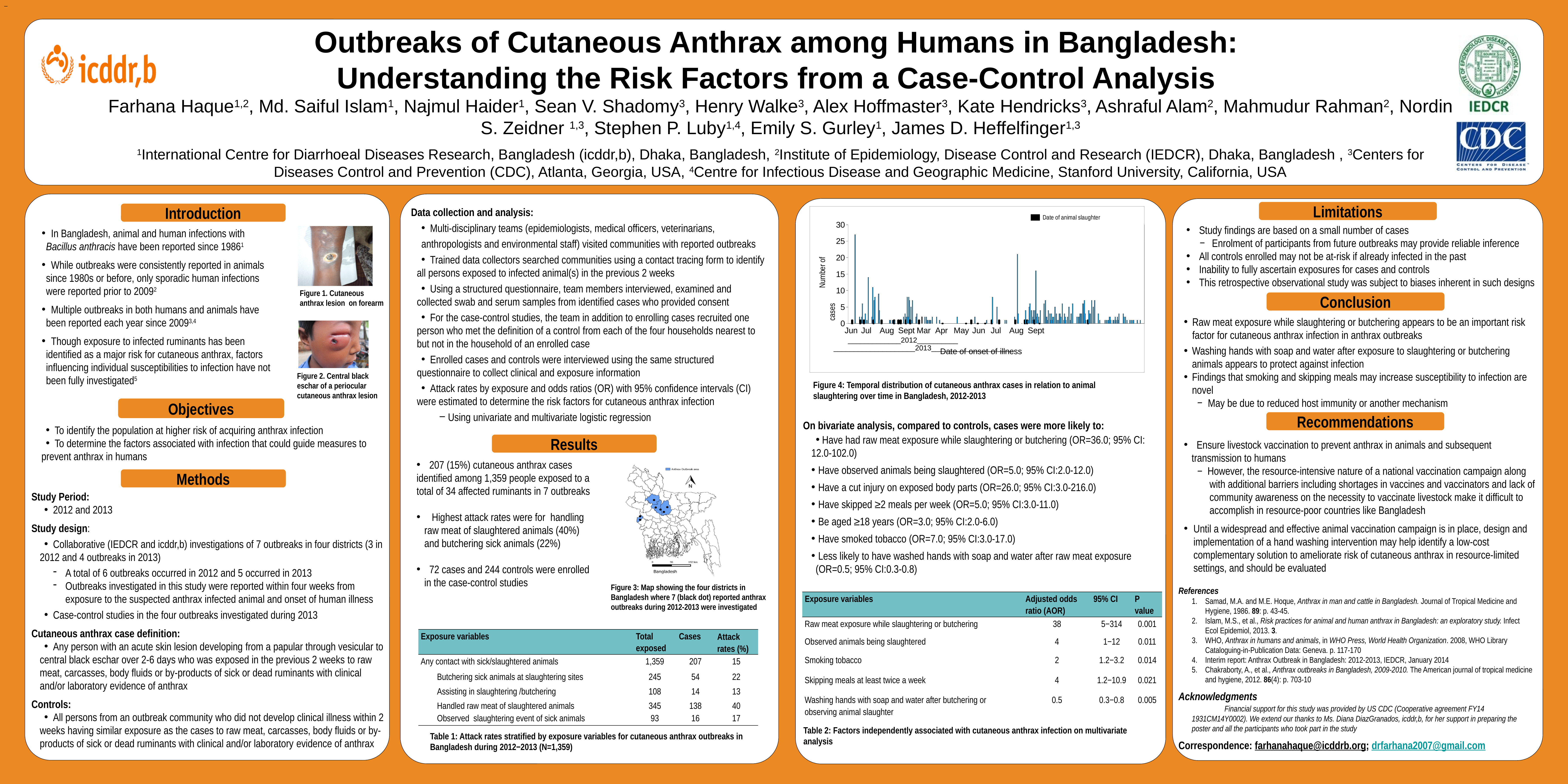
How many month labels appear on the x axis of Figure 4? 11 What kind of chart is Figure 4? bar chart In Figure 4, is the tallest bar greater or less than 25 cases? greater How many years are labelled on the x axis of Figure 4? 2 How many entries does the legend of Figure 4 list? 1 In Figure 4, what is the highest value shown on the y axis? 30 In Figure 4, is the tallest bar greater or less than 30 cases? less In Figure 4, what does the legend entry with the black marker represent? Date of animal slaughter